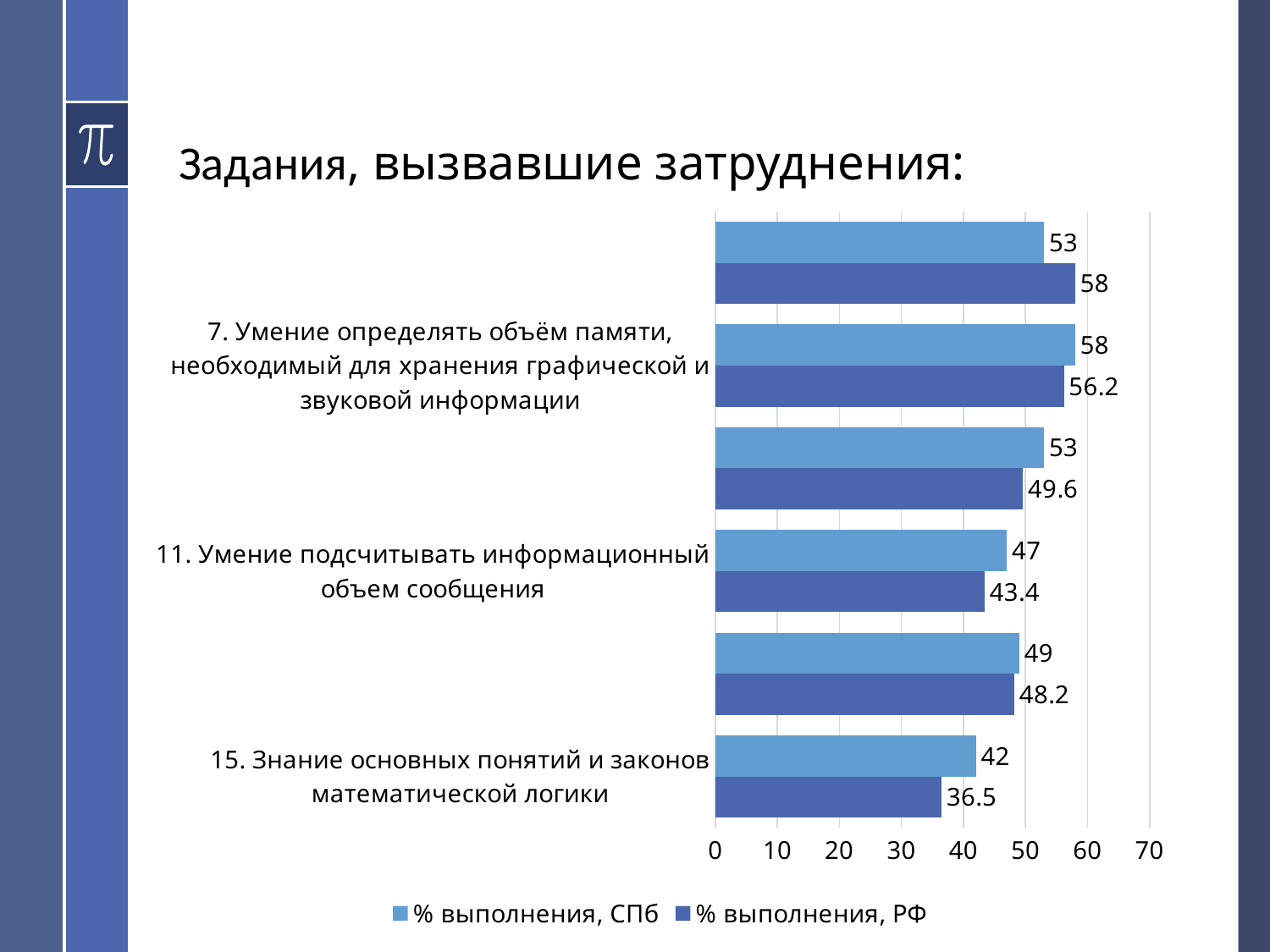
What is the value of "% выполнения, РФ" for task 15 (Знание основных понятий и законов математической логики)? 36.5 For task 11 (Умение подсчитывать информационный объем сообщения), which is larger: the СПб value or the РФ value? СПб What are the two series named in the legend? % выполнения, СПб and % выполнения, РФ What is the title of the slide? Задания, вызвавшие затруднения: How many groups of bars are plotted in the chart? 6 What is the difference between the СПб and РФ values for task 15 (Знание основных понятий и законов математической логики)? 5.5 What is the value of "% выполнения, СПб" for task 11 (Умение подсчитывать информационный объем сообщения)? 47 What is the value of "% выполнения, РФ" for task 7 (Умение определять объём памяти, необходимый для хранения графической и звуковой информации)? 56.2 How many series does the legend list? 2 What kind of chart is shown on the slide? bar chart What is the value of "% выполнения, РФ" for task 11 (Умение подсчитывать информационный объем сообщения)? 43.4 What is the value of "% выполнения, СПб" for task 15 (Знание основных понятий и законов математической логики)? 42